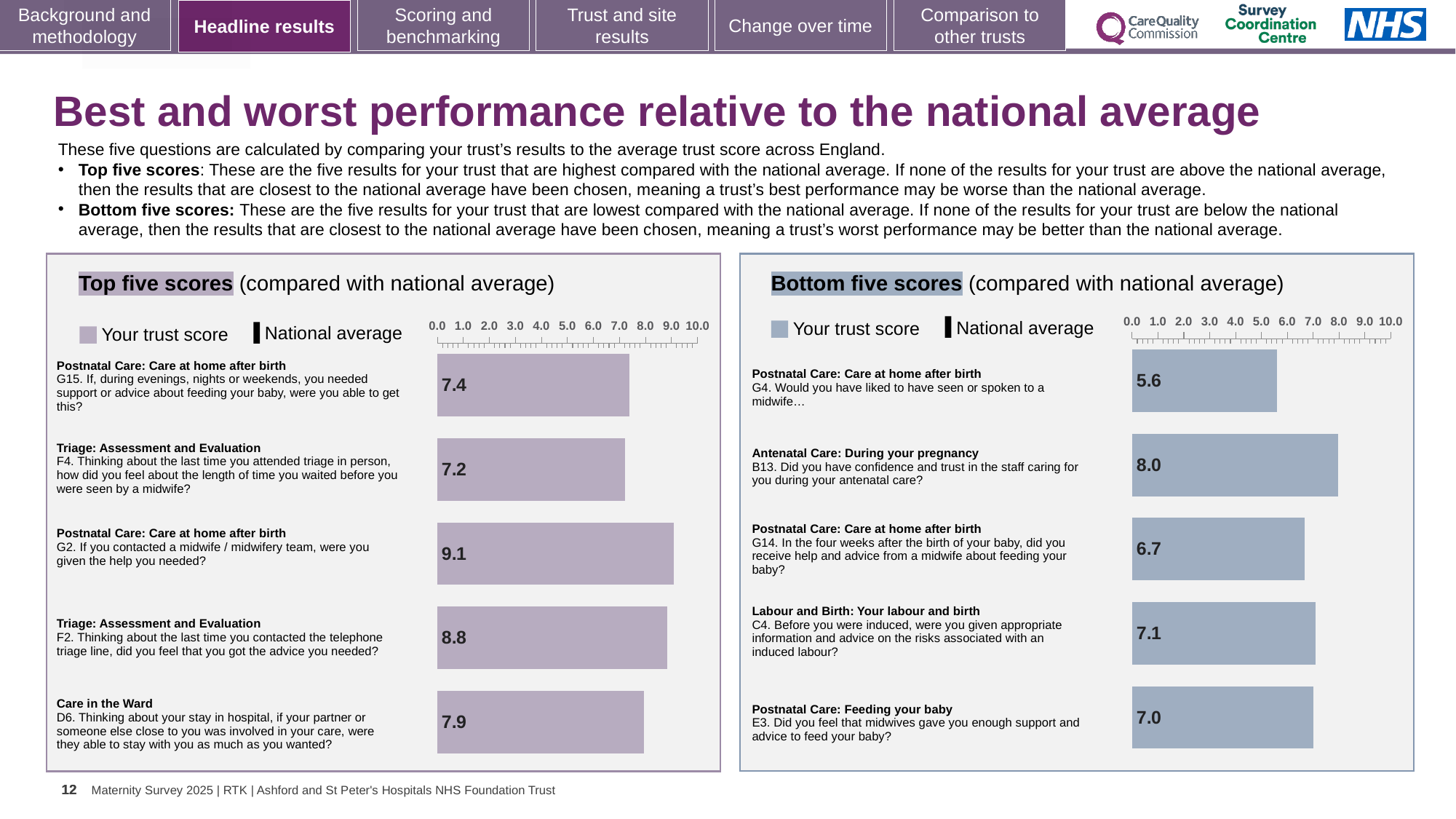
In the Bottom five scores chart, which has the larger trust score, B13 or G14? B13 In the Top five scores chart, is the trust score for F2 greater or less than 8.0? greater How many bars are shown in the Bottom five scores chart? 5 In the Top five scores chart, which question has the lowest trust score? F4 (7.2) In the Top five scores chart, what is the trust score for G2 (If you contacted a midwife / midwifery team, were you given the help you needed?)? 9.1 In the Bottom five scores chart, what is the trust score for G4 (Would you have liked to have seen or spoken to a midwife…)? 5.6 In the Top five scores chart, what is the difference between the trust scores for G2 and F4? 1.9 In the Top five scores chart, what is the trust score for D6 (Care in the Ward)? 7.9 In the Bottom five scores chart, which question has the lowest trust score? G4 (5.6) What type of chart is used in the Top five scores panel? Bar chart In the Bottom five scores chart, what is the difference between the trust scores for B13 and E3? 1.0 In the Top five scores chart, which question has the highest trust score? G2 (9.1)